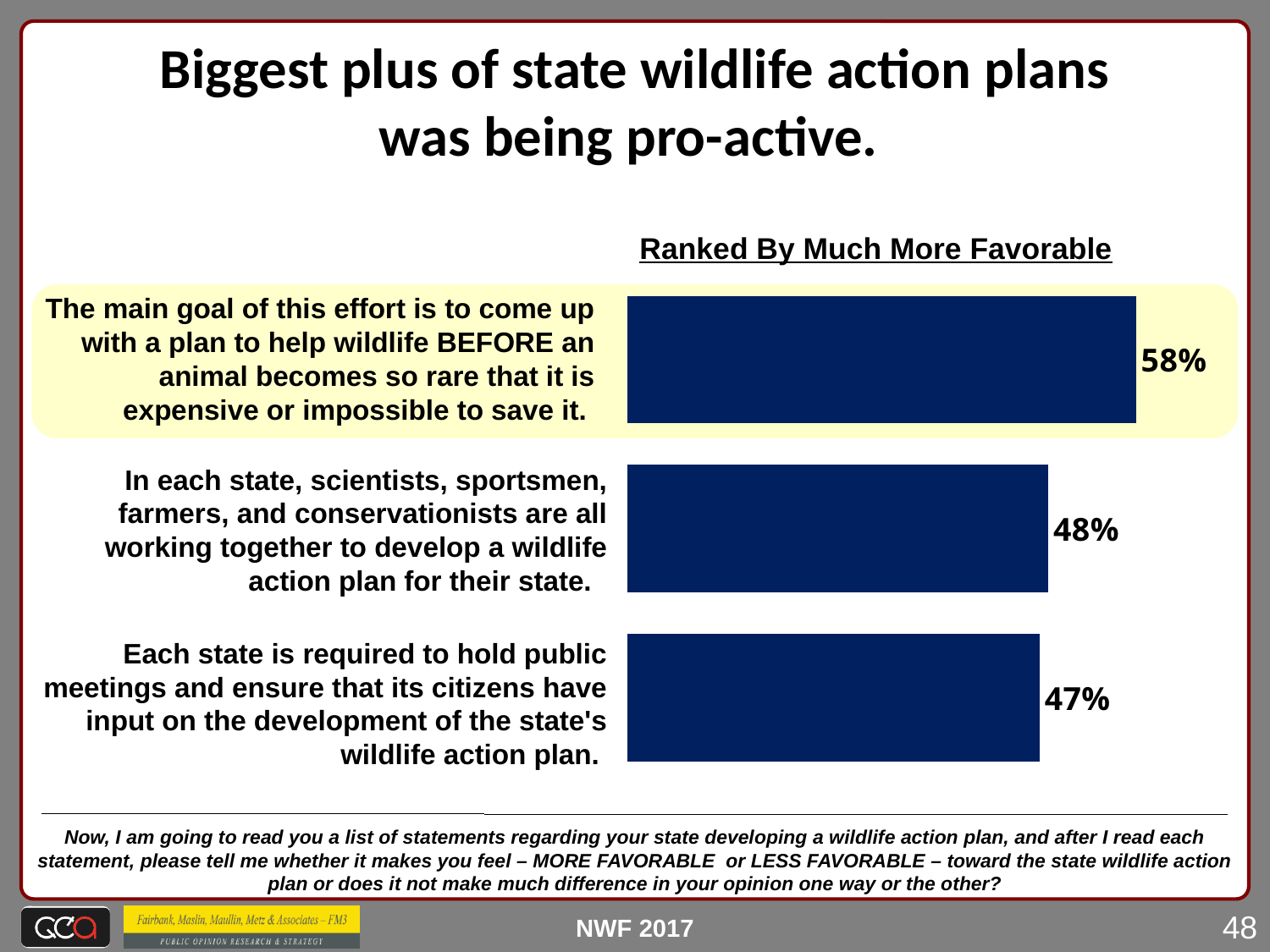
Which statement has the lowest 'Much More Favorable' percentage? Each state is required to hold public meetings and ensure that its citizens have input on the development of the state's wildlife action plan. What type of chart is shown on the slide? Bar chart What percentage said 'Much More Favorable' for the statement that each state is required to hold public meetings and ensure citizens have input? 47% What colour are the bars in the chart? Dark blue What percentage said 'Much More Favorable' for the statement about coming up with a plan to help wildlife BEFORE an animal becomes so rare that it is expensive or impossible to save it? 58% What is the heading above the bars that indicates how the statements are ranked? Ranked By Much More Favorable What percentage said 'Much More Favorable' for the statement that scientists, sportsmen, farmers, and conservationists are all working together to develop a wildlife action plan? 48% What is the difference in percentage points between the highest bar (58%) and the lowest bar (47%)? 11 Which has a larger 'Much More Favorable' percentage: the statement about helping wildlife BEFORE an animal becomes rare, or the statement about scientists, sportsmen, farmers, and conservationists working together? The statement about helping wildlife BEFORE an animal becomes rare How many statements (bars) are shown in the chart? 3 Which statement has the highest 'Much More Favorable' percentage? The main goal of this effort is to come up with a plan to help wildlife BEFORE an animal becomes so rare that it is expensive or impossible to save it. What is the difference in percentage points between the 'working together' statement and the 'public meetings' statement? 1